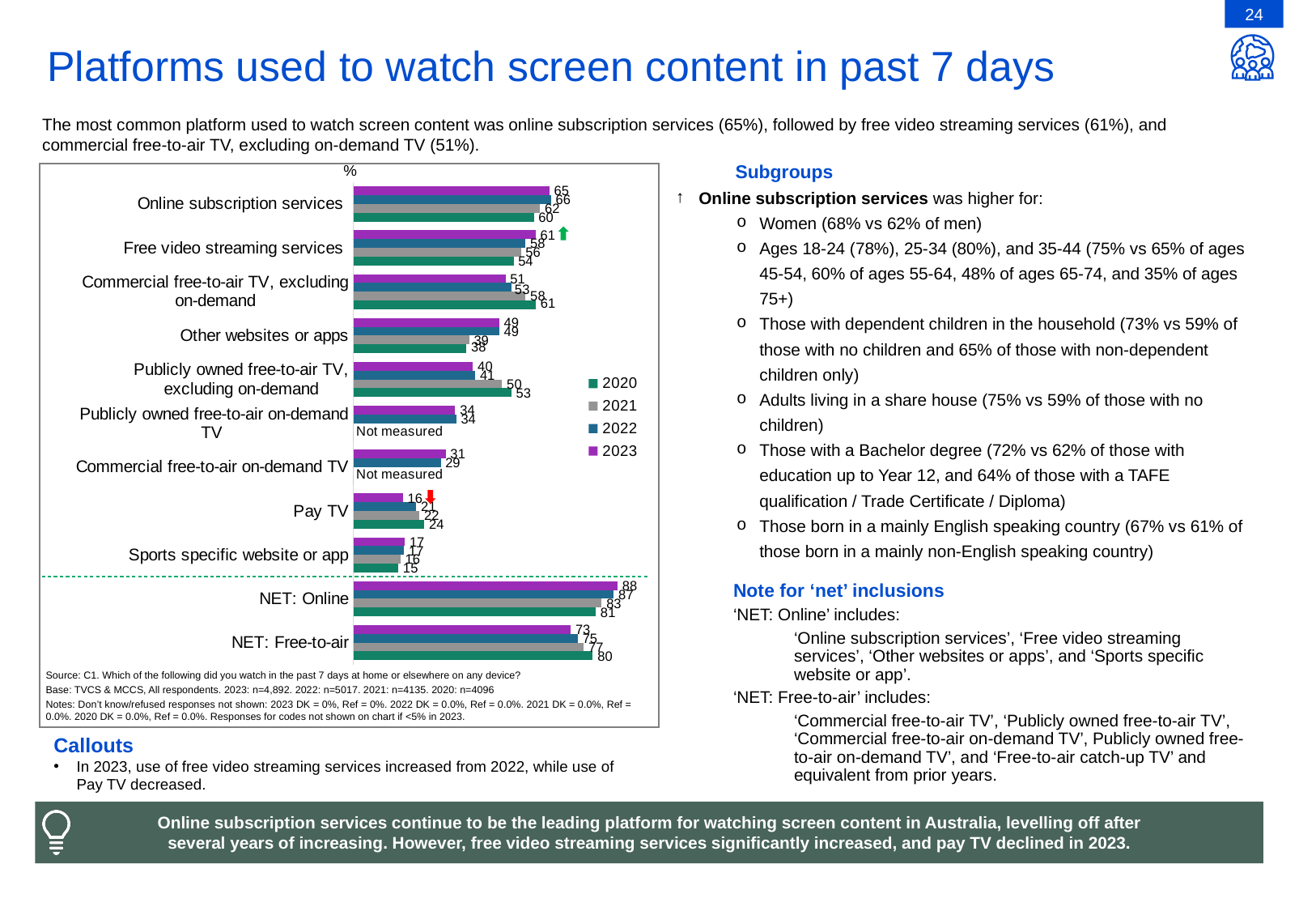
Which platform has the lowest 2023 value? Pay TV What kind of chart is shown on the slide? Bar chart What is the difference between the 2023 and 2022 values for Free video streaming services? 3 What is the 2023 value for NET: Online? 88 Did the value for NET: Free-to-air rise or fall from 2020 to 2023? Fall Which platform has the highest 2023 value, excluding the NET categories? Online subscription services What is the 2022 value for Pay TV? 21 Which years are shown as 'Not measured' for Commercial free-to-air on-demand TV? 2020 and 2021 What is the 2023 value for Online subscription services? 65 What is the 2020 value for Commercial free-to-air TV, excluding on-demand? 61 How many series does the chart legend list? 4 Which is larger for Publicly owned free-to-air TV, excluding on-demand: the 2020 value or the 2023 value? 2020